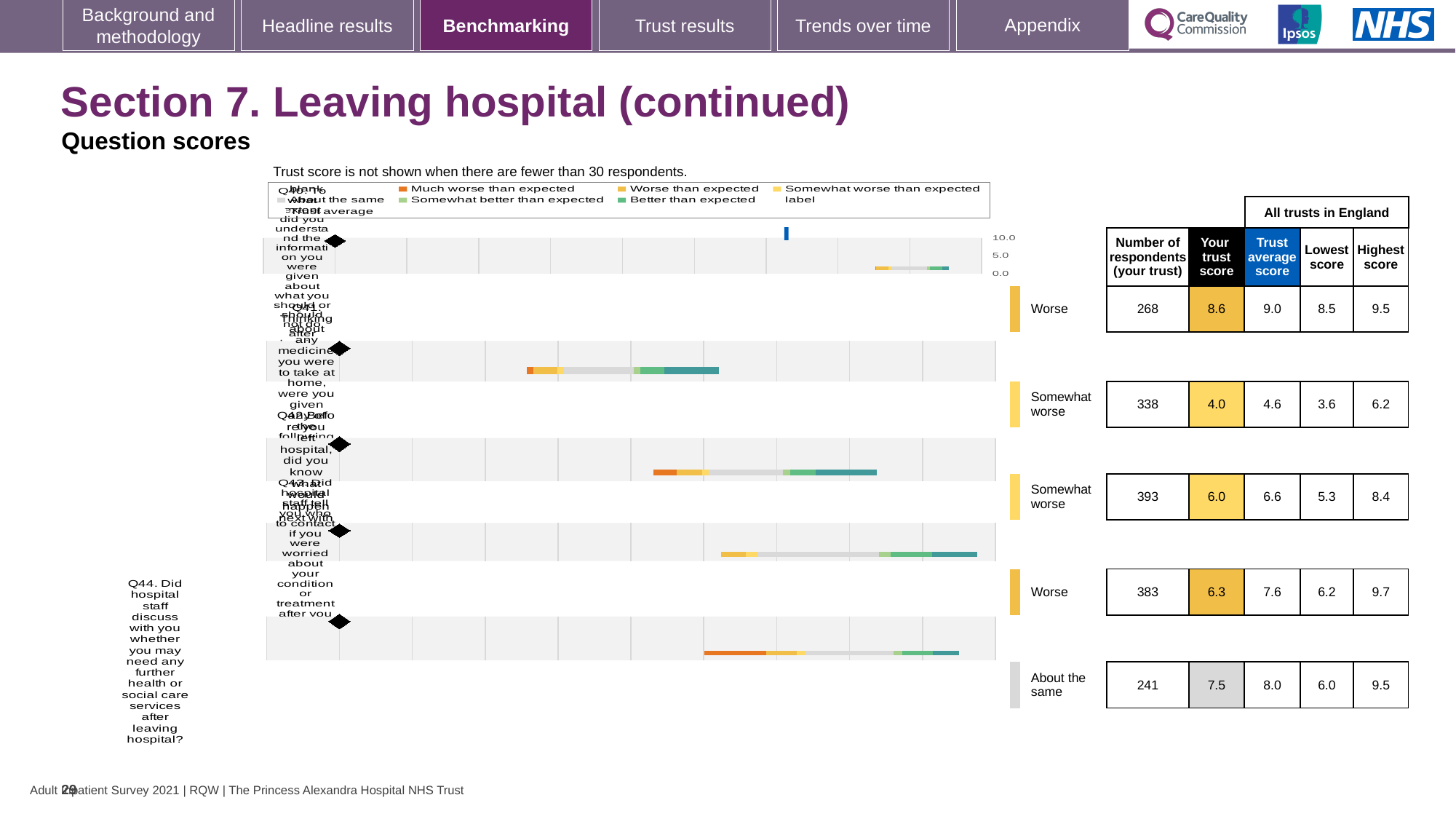
Which row of the table has the highest 'Your trust score', and what is it? The first row, 8.6 What is the highest score across all trusts in England for Q44? 9.5 What benchmark rating is shown for Q44? About the same For Q44, which is larger: your trust score or the trust average score? Trust average score How many question rows are shown in the chart and table? 5 For Q44, what is the difference between the trust average score and your trust score? 0.5 What is the trust average score for Q44? 8.0 In the table, what is the 'Your trust score' for Q44 (Did hospital staff discuss with you whether you may need any further health or social care services after leaving hospital?)? 7.5 What is the lowest 'Your trust score' shown in the table? 4.0 How many of the question rows are rated 'Worse'? 2 What is the lowest score across all trusts in England for Q44? 6.0 How many respondents from your trust answered Q44? 241